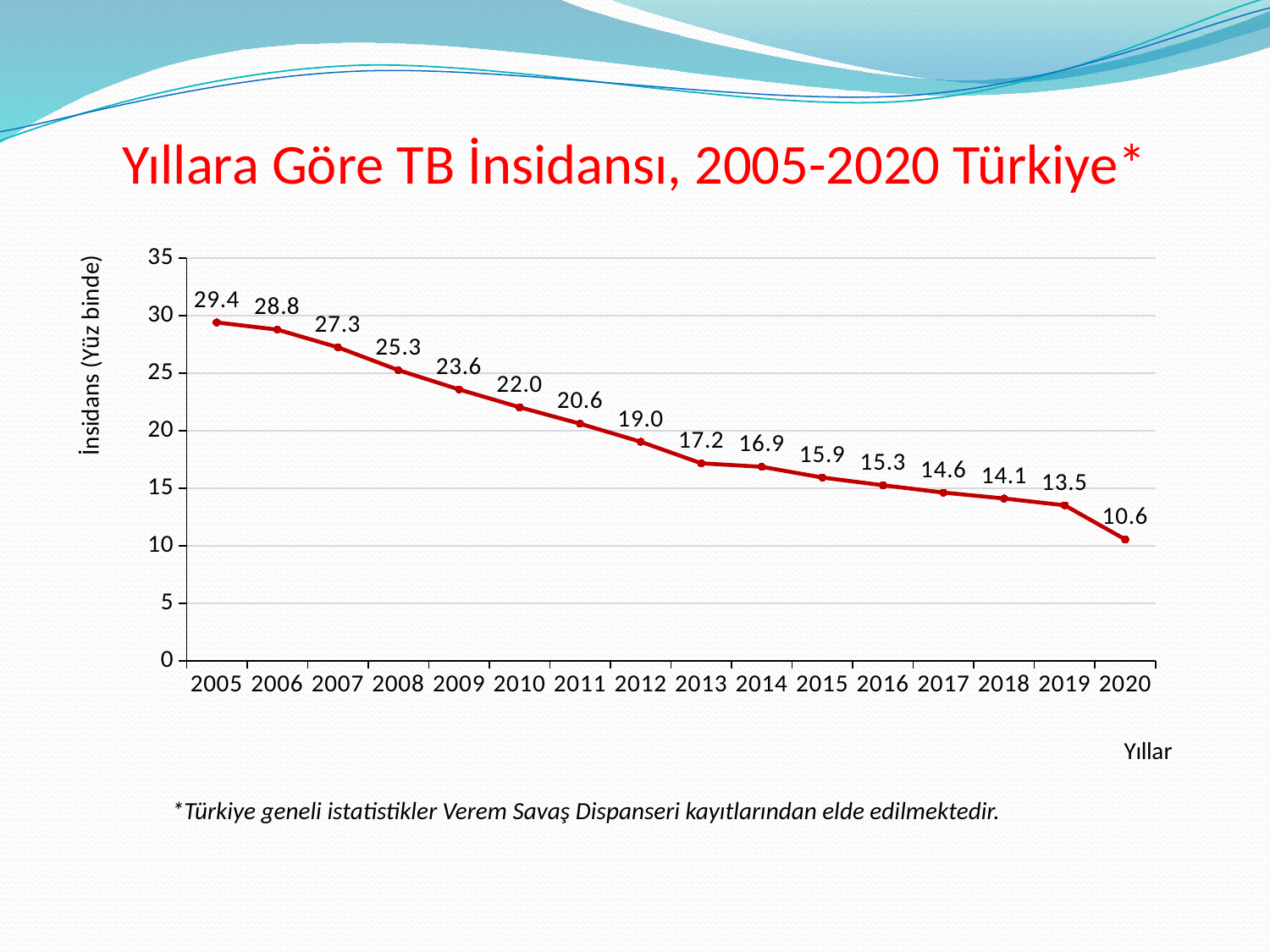
Do the TB incidence values rise or fall from 2005 to 2020? Fall What is the difference between the TB incidence in 2019 and 2020? 2.9 What is the TB incidence value for 2013? 17.2 What is the TB incidence value for 2020? 10.6 What kind of chart is shown on the slide? Line chart How many years are plotted on the chart? 16 What is the label of the y axis? İnsidans (Yüz binde) What is the difference between the TB incidence in 2005 and 2020? 18.8 Which year has the lowest TB incidence? 2020 What is the TB incidence value for 2005? 29.4 Which year has a higher TB incidence, 2010 or 2015? 2010 Which year has the highest TB incidence? 2005